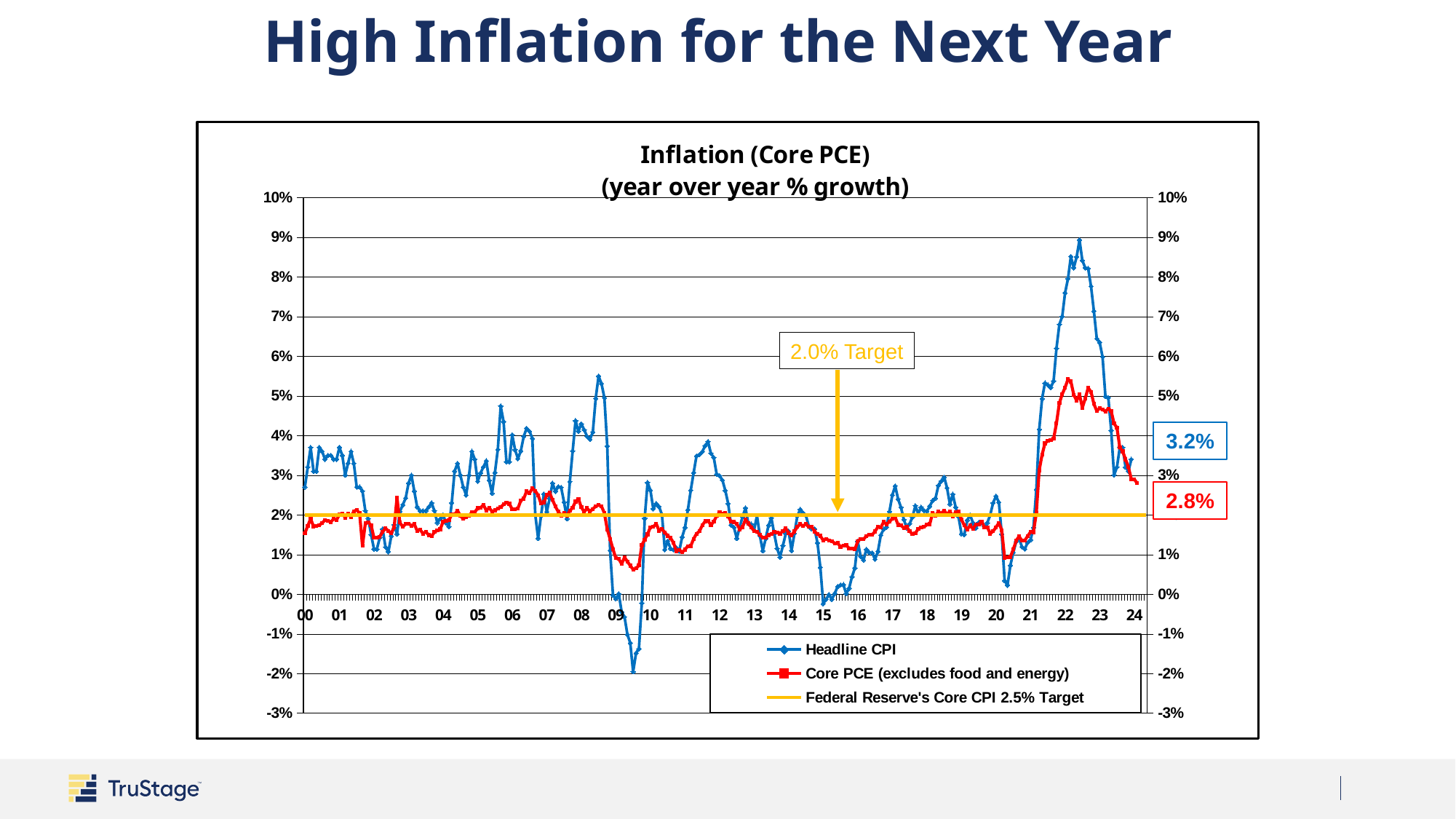
How many series does the legend list? 3 What kind of chart is shown on the slide? line chart Which series reaches the highest peak on the chart? Headline CPI What does the annotation box pointing to the yellow line say? 2.0% Target Is the peak of Headline CPI in 2022 greater or less than 8%? greater Is the peak of Core PCE in 2022 greater or less than 5%? greater At the right end of the chart, which is higher: the labelled Headline CPI value or the labelled Core PCE value? Headline CPI What is the latest labelled value for Core PCE at the right end of the chart? 2.8% What is the legend label for the yellow line? Federal Reserve's Core CPI 2.5% Target What is the latest labelled value for Headline CPI at the right end of the chart? 3.2% Is the lowest point of Headline CPI in 2009 greater or less than -1%? less What is the difference between the labelled end values for Headline CPI (3.2%) and Core PCE (2.8%)? 0.4 percentage points